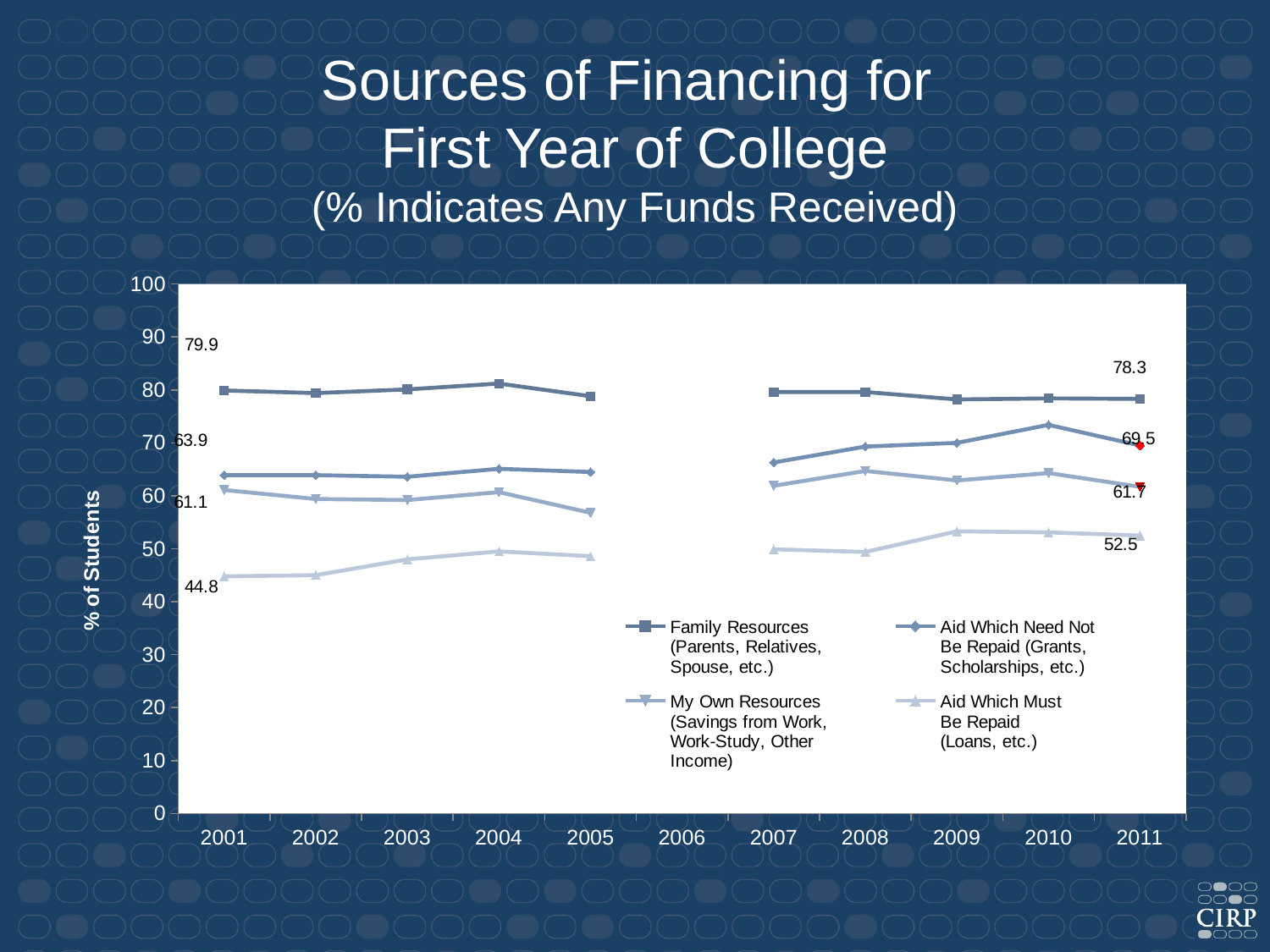
By how much did Aid Which Must Be Repaid change from 2001 (44.8) to 2011 (52.5)? 7.7 What is the difference between Aid Which Need Not Be Repaid in 2011 (69.5) and in 2001 (63.9)? 5.6 What is the value for Family Resources in 2001? 79.9 Which series has the highest value in 2011? Family Resources (Parents, Relatives, Spouse, etc.) What type of chart is shown on the slide? line chart Is the value for Family Resources in 2005 greater or less than 70? greater What is the value for Aid Which Must Be Repaid in 2001? 44.8 What is the value for My Own Resources in 2011? 61.7 Which series has the lowest value in 2001? Aid Which Must Be Repaid (Loans, etc.) What is the value for Family Resources in 2011? 78.3 How many series does the legend list? 4 What is the value for Aid Which Need Not Be Repaid in 2011? 69.5